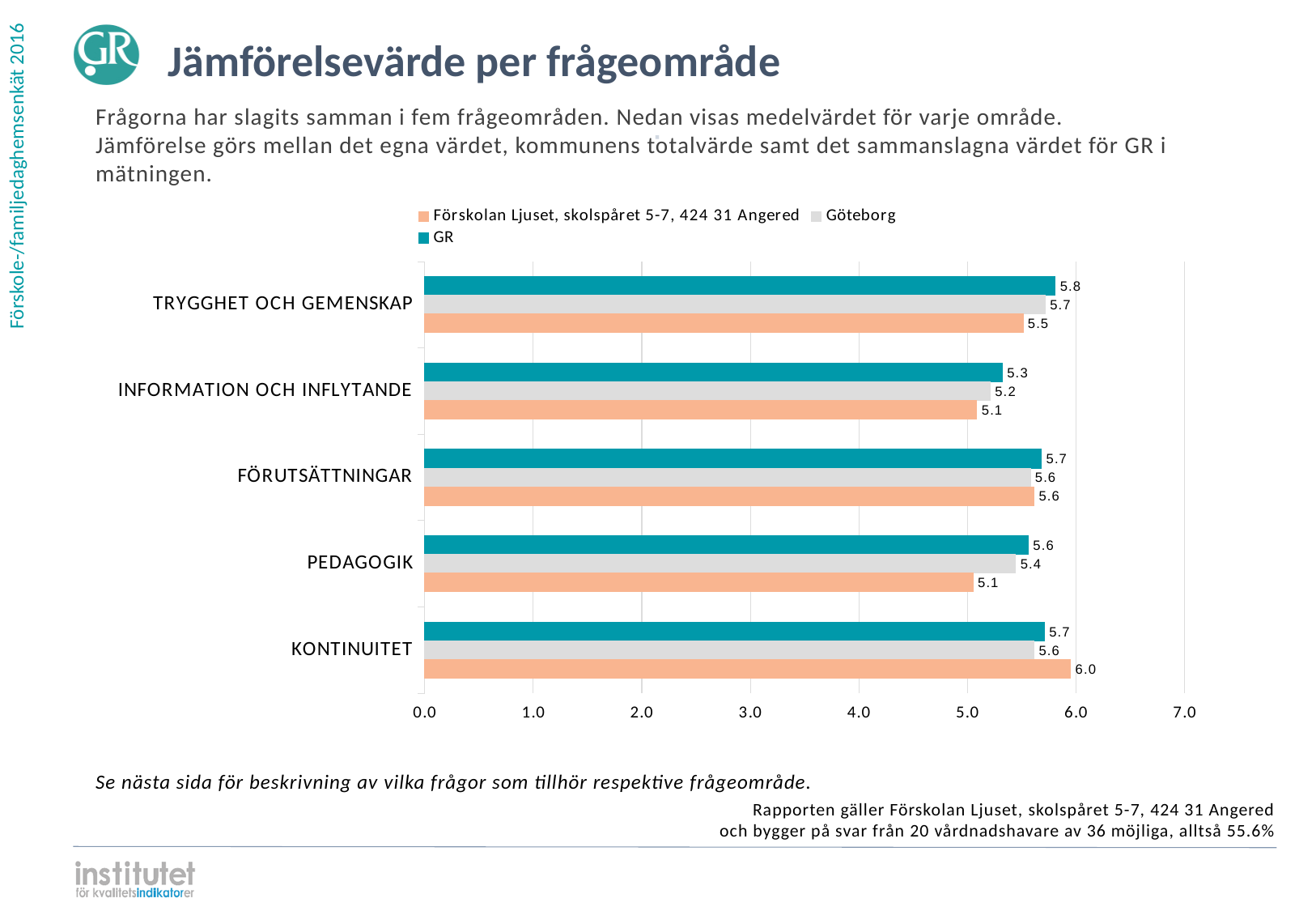
What is the Göteborg value for PEDAGOGIK? 5.4 How many series does the legend list? 3 Which category has the lowest GR value? INFORMATION OCH INFLYTANDE What is the difference between the GR value and the Förskolan Ljuset value for PEDAGOGIK? 0.5 For KONTINUITET, which is larger: the Förskolan Ljuset value or the GR value? Förskolan Ljuset How many categories (frågeområden) are shown on the chart? 5 What is the GR value for TRYGGHET OCH GEMENSKAP? 5.8 What kind of chart is shown on the slide? Bar chart What is the value for Förskolan Ljuset in INFORMATION OCH INFLYTANDE? 5.1 What is the value for Förskolan Ljuset in the KONTINUITET category? 6.0 Which category has the highest value for Förskolan Ljuset? KONTINUITET Which series is shown in orange in the legend? Förskolan Ljuset, skolspåret 5-7, 424 31 Angered